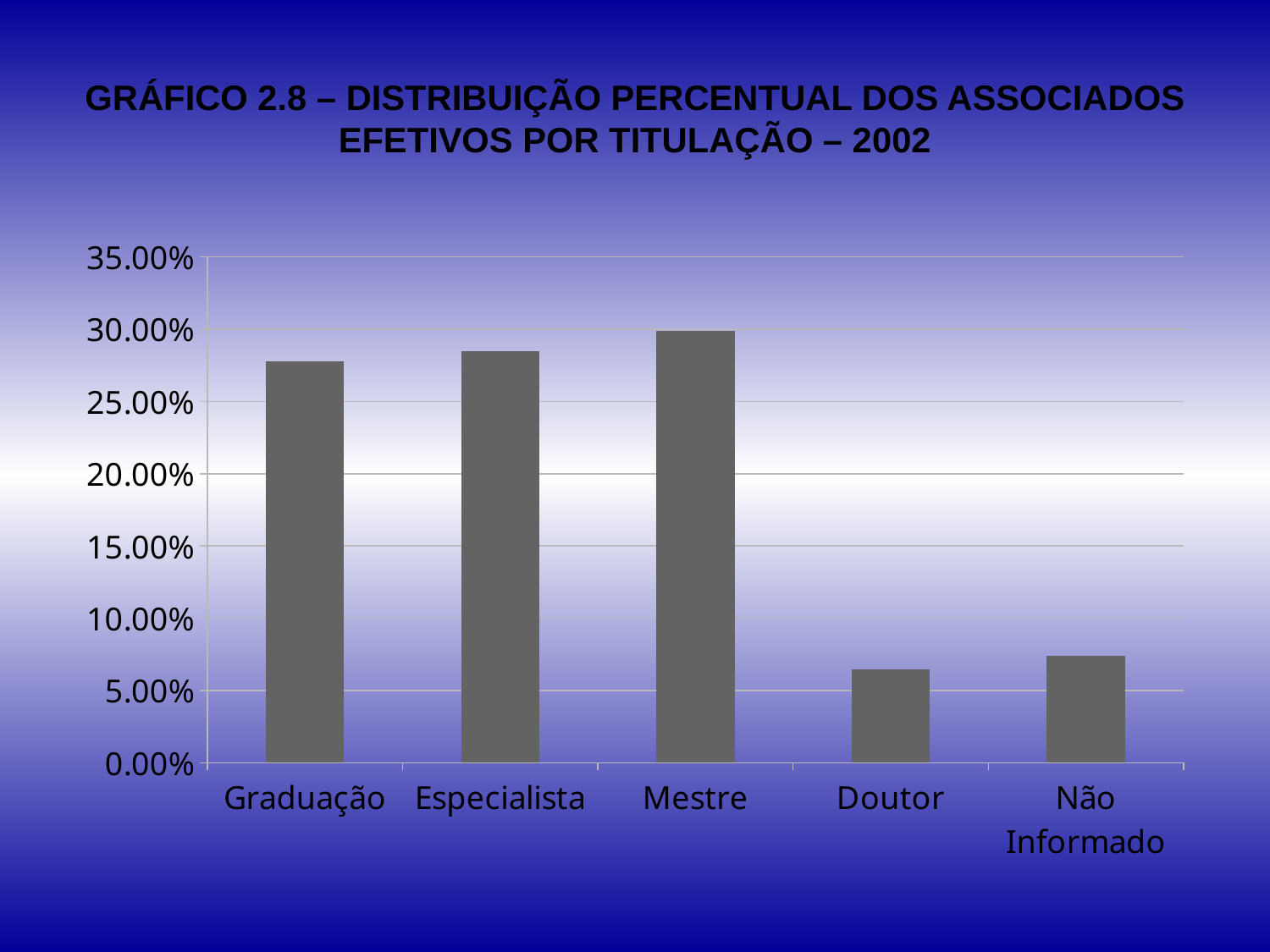
Which category has the highest value in the chart? Mestre What kind of chart is shown on the slide? bar chart Is the value for Doutor greater or less than 10.00%? less Which category has the lowest value in the chart? Doutor Is the value for Especialista greater or less than 25.00%? greater Is the value for Graduação greater or less than 25.00%? greater How many categories are shown on the x axis of the chart? 5 Which is larger, the value for Mestre or the value for Doutor? Mestre Which is larger, the value for Não Informado or the value for Graduação? Graduação What year is referenced in the chart title? 2002